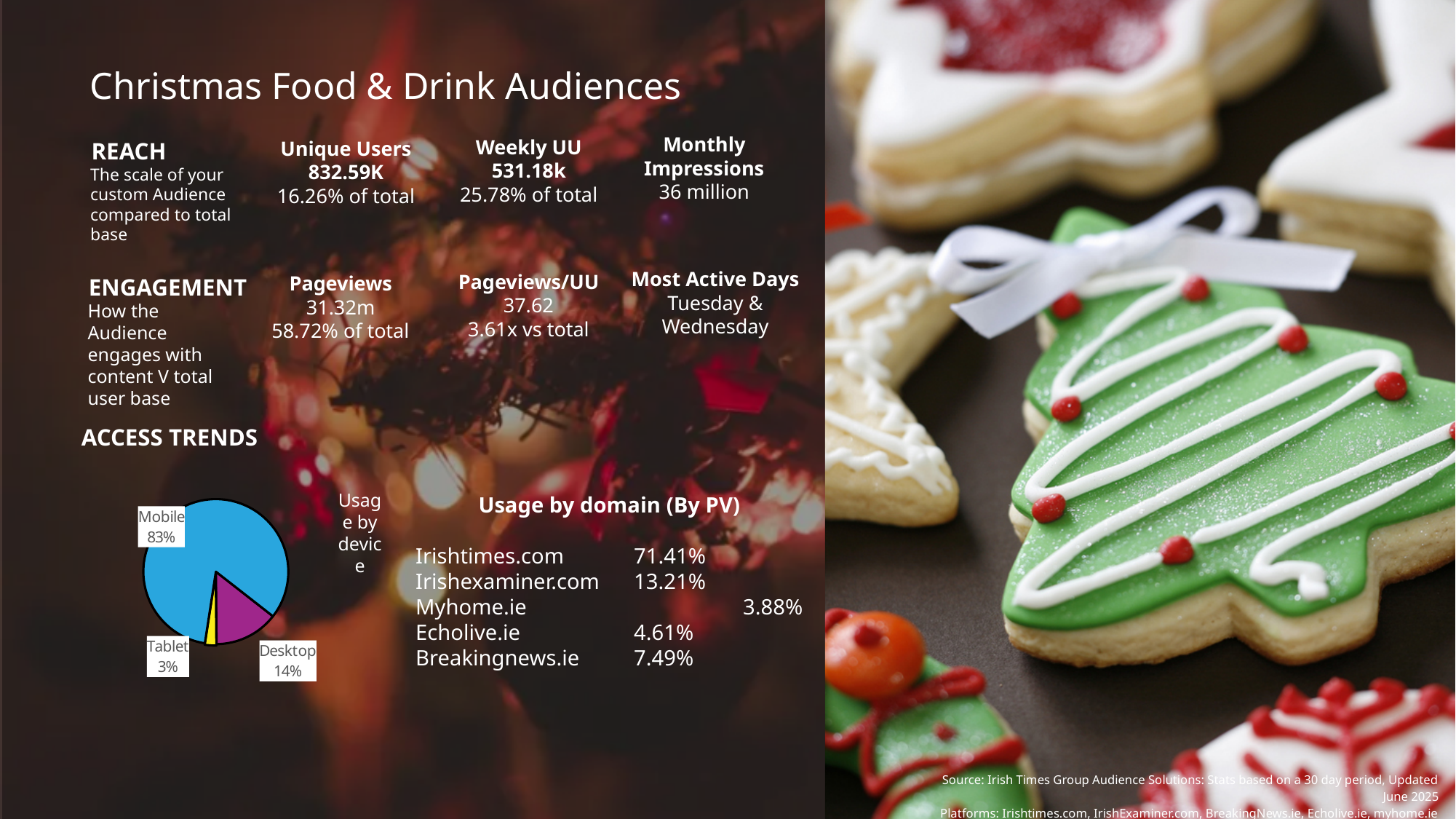
In the usage by device pie chart, how many percentage points larger is Desktop than Tablet? 11 What kind of chart is used to show usage by device? pie chart What colour is the Desktop slice in the usage by device pie chart? purple Which device has the largest share in the usage by device pie chart? Mobile Which device has the smallest share in the usage by device pie chart? Tablet In the usage by device pie chart, which is larger, Desktop or Tablet? Desktop In the usage by device pie chart, how many percentage points larger is Mobile than Desktop? 69 What share of usage by device is Mobile? 83% What share of usage by device is Tablet? 3% What share of usage by device is Desktop? 14% How many slices does the usage by device pie chart have? 3 What colour is the Mobile slice in the usage by device pie chart? blue